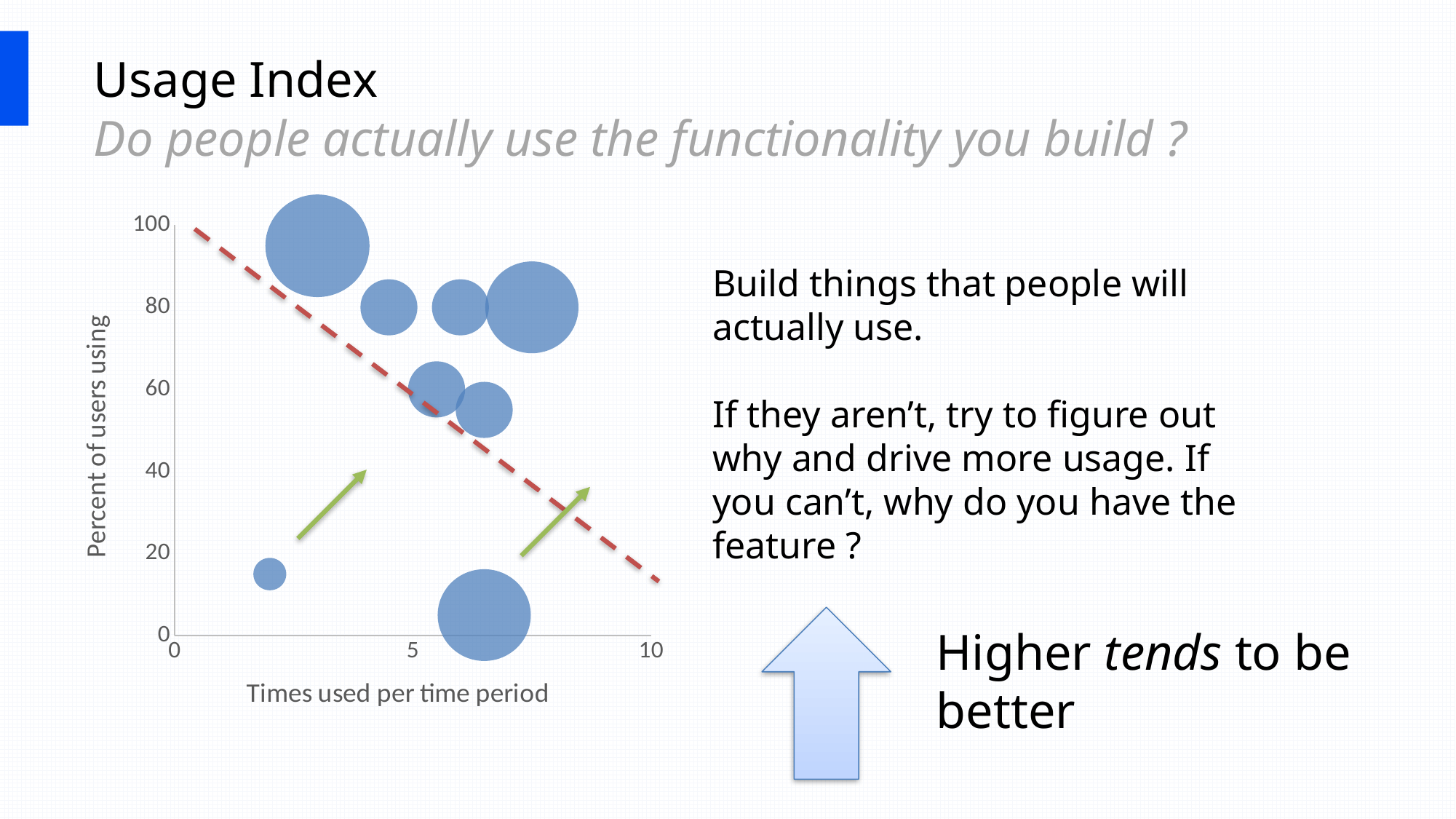
What is the title of the vertical axis of the chart? Percent of users using Does the red dashed line on the chart rise or fall from left to right? fall What is the maximum value shown on the horizontal axis of the chart? 10 What is the title of the horizontal axis of the chart? Times used per time period Is the vertical-axis value of the highest bubble on the chart greater or less than 80? greater What kind of chart is shown on the slide? Bubble chart How many bubbles are plotted on the chart? 8 What is the maximum value shown on the vertical axis of the chart? 100 Is the vertical-axis value of the lowest bubble on the chart greater or less than 20? less Is the horizontal-axis value of the leftmost bubble on the chart greater or less than 5? less